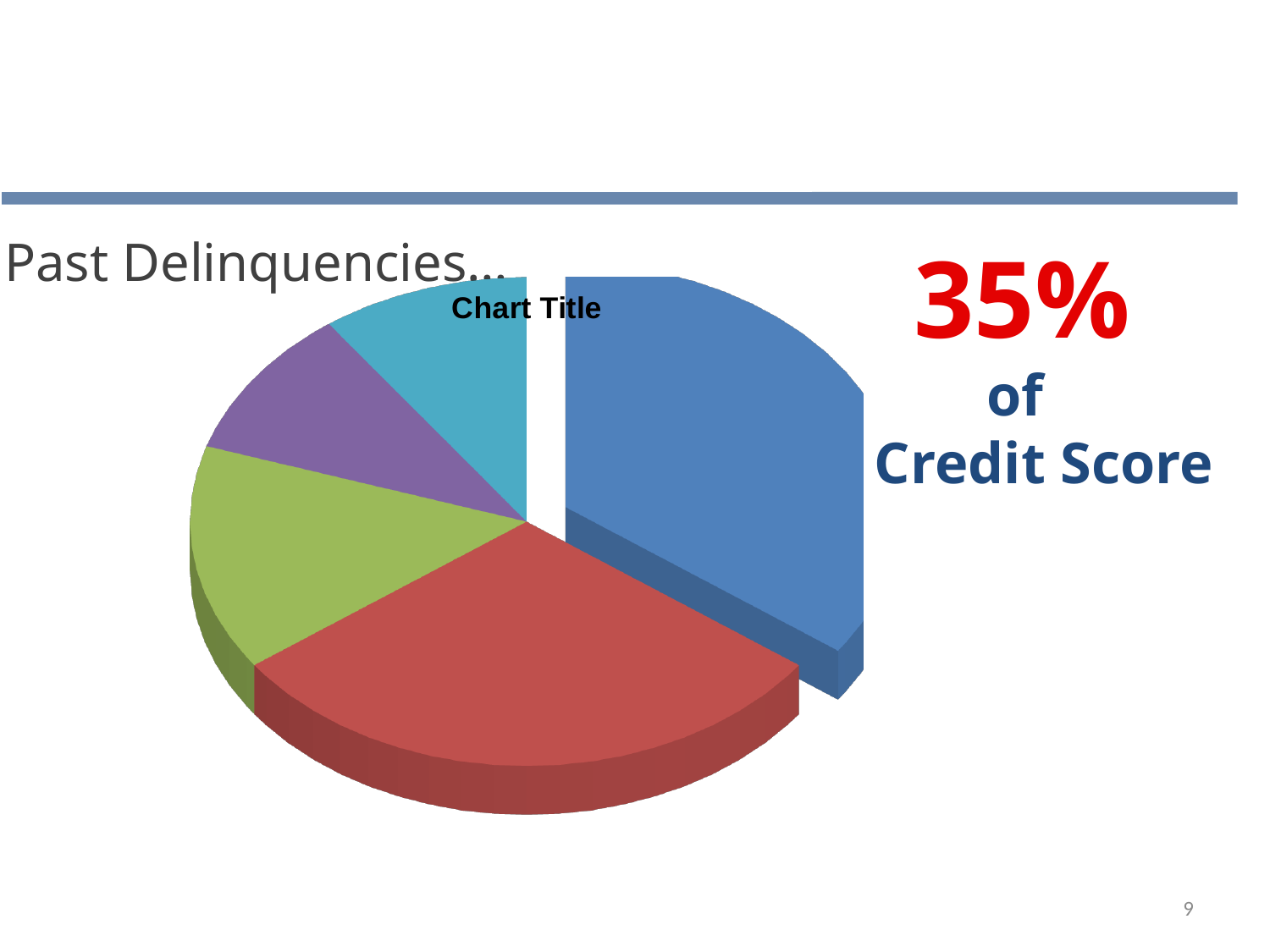
What kind of chart is shown on the slide? pie chart Which slice is larger, the red slice or the teal slice? the red slice Which slice is larger, the blue slice or the green slice? the blue slice Which slice is larger, the red slice or the purple slice? the red slice What is the title printed on the chart? Chart Title Which slice of the pie chart is the largest? the blue slice How many slices does the pie chart have? 5 Which slice is pulled out (exploded) from the rest of the pie? the blue slice